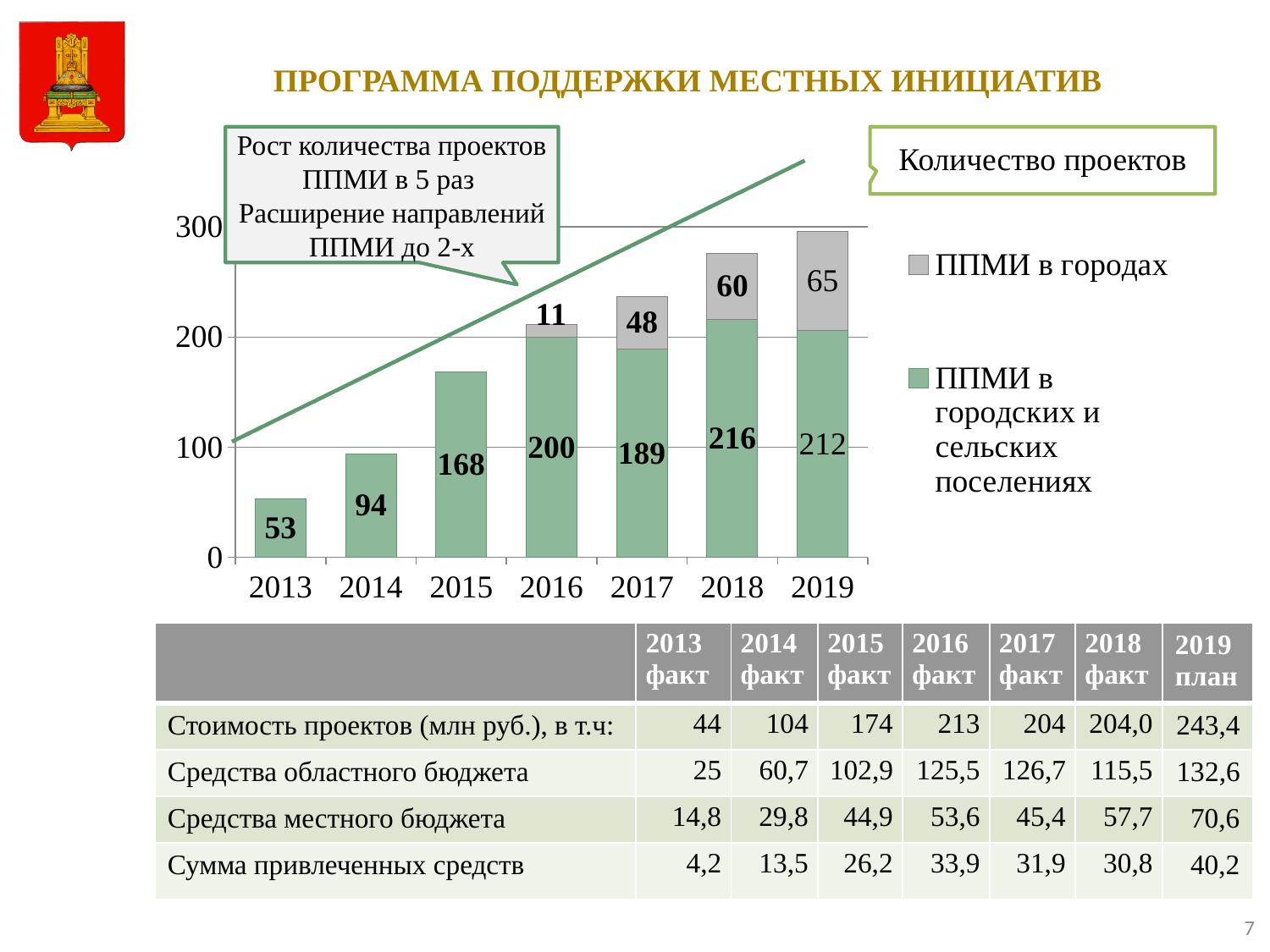
Which year has the lowest value for 'ППМИ в городских и сельских поселениях'? 2013 What is the difference between the 'ППМИ в городских и сельских поселениях' values for 2015 and 2014? 74 What is the title of the chart? Количество проектов What kind of chart is shown on the slide? stacked bar chart Which year has the highest value for 'ППМИ в городах'? 2019 Which is larger: the 'ППМИ в городских и сельских поселениях' value for 2016 or for 2017? 2016 What is the value for 'ППМИ в городских и сельских поселениях' in 2018? 216 What is the value for 'ППМИ в городах' in 2017? 48 How many series does the chart legend list? 2 What is the value for 'ППМИ в городских и сельских поселениях' in 2013? 53 How many years are shown on the x axis of the chart? 7